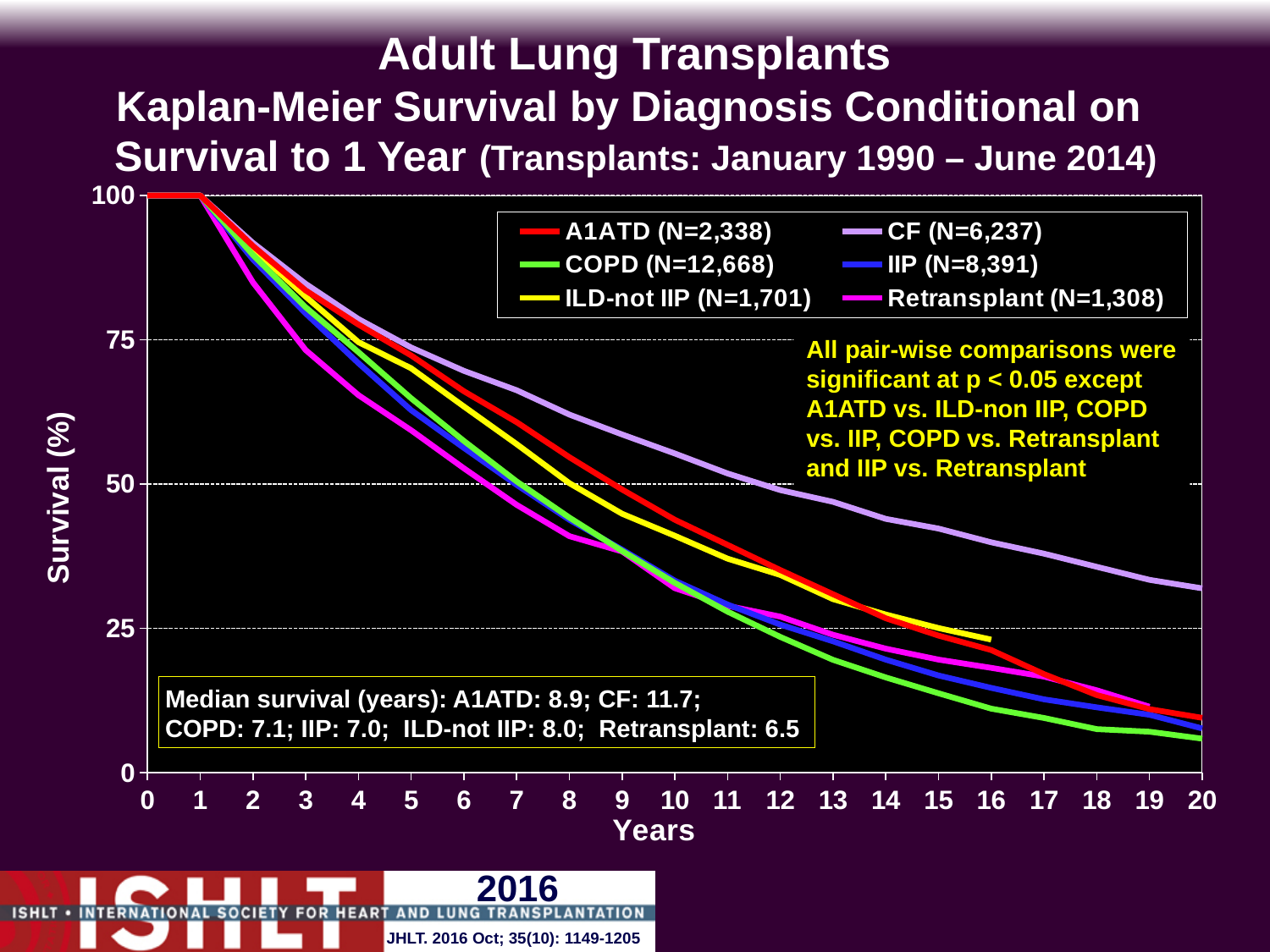
What is the median survival in years for CF according to the text box? 11.7 Do the survival curves rise or fall as years increase? fall What is the difference between the median survival of CF and A1ATD in years? 2.8 At 15 years, which has higher survival: CF or COPD? CF How many series does the legend list? 6 What kind of chart is shown on the slide? line chart What is the median survival in years for Retransplant according to the text box? 6.5 Which diagnosis group has the highest survival at 20 years? CF What is the N shown in the legend for COPD? N=12,668 Is the survival for COPD at 10 years greater or less than 50? less Is the survival for CF at 10 years greater or less than 50? greater Which diagnosis group has the lowest survival at 20 years? COPD